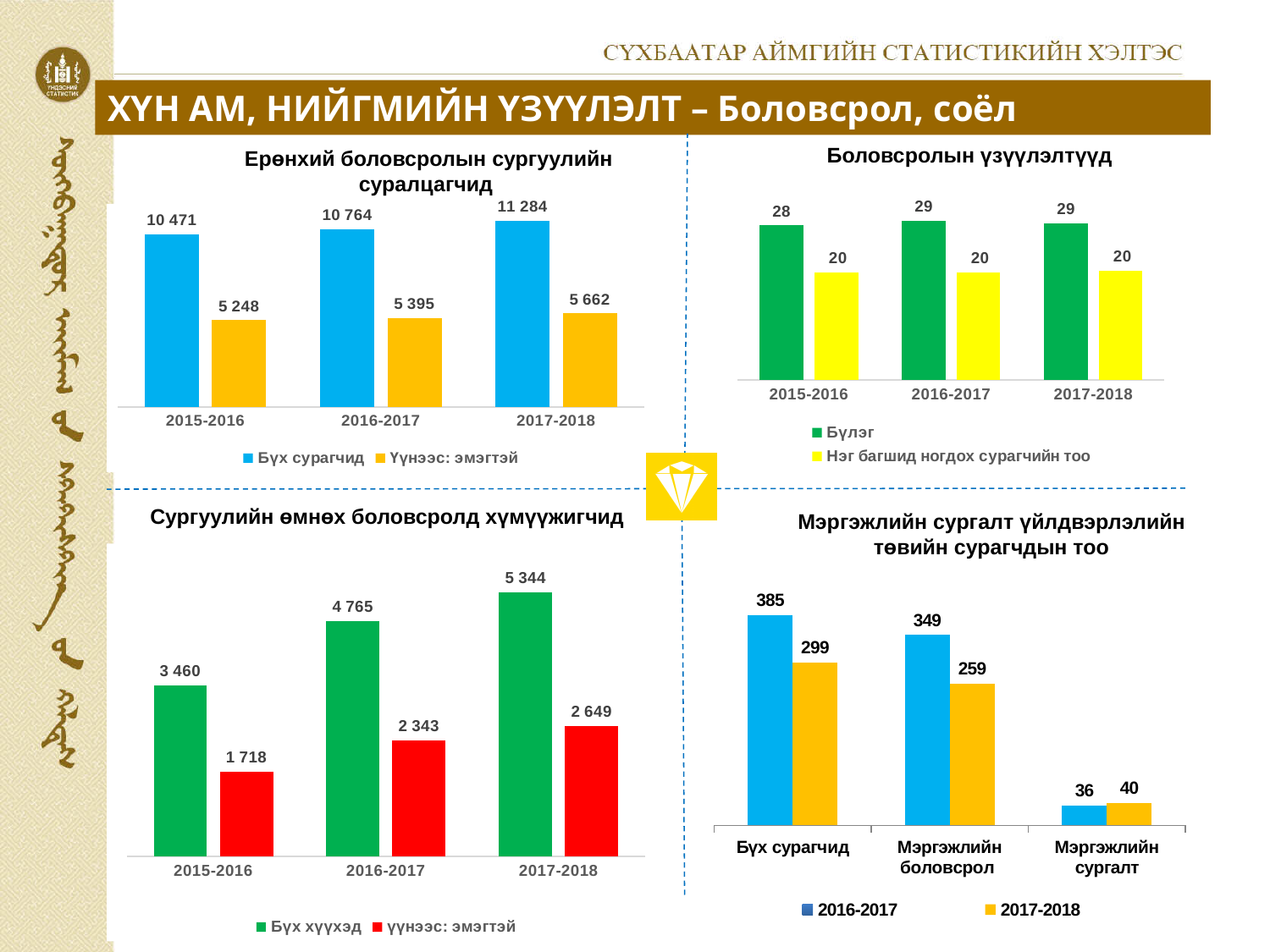
In the chart titled "Мэргэжлийн сургалт үйлдвэрлэлийн төвийн сурагчдын тоо", which is larger for "Мэргэжлийн сургалт": 2016-2017 or 2017-2018? 2017-2018 In the chart titled "Мэргэжлийн сургалт үйлдвэрлэлийн төвийн сурагчдын тоо", what is the value for "Мэргэжлийн боловсрол" in 2017-2018? 259 In the chart titled "Ерөнхий боловсролын сургуулийн суралцагчид", do the values for "Бүх сурагчид" rise or fall from 2015-2016 to 2017-2018? rise In the chart titled "Сургуулийн өмнөх боловсролд хүмүүжигчид", what kind of chart is shown? bar chart In the chart titled "Ерөнхий боловсролын сургуулийн суралцагчид", what is the difference between "Бүх сурагчид" and "Үүнээс: эмэгтэй" for 2015-2016? 5 223 In the chart titled "Мэргэжлийн сургалт үйлдвэрлэлийн төвийн сурагчдын тоо", how many categories are shown on the x axis? 3 In the chart titled "Боловсролын үзүүлэлтүүд", how many series does the legend list? 2 In the chart titled "Ерөнхий боловсролын сургуулийн суралцагчид", what is the value of "Бүх сурагчид" for 2017-2018? 11 284 In the chart titled "Боловсролын үзүүлэлтүүд", what is the value of "Нэг багшид ногдох сурагчийн тоо" for 2017-2018? 20 In the chart titled "Сургуулийн өмнөх боловсролд хүмүүжигчид", what is the value of "үүнээс: эмэгтэй" for 2016-2017? 2 343 In the chart titled "Боловсролын үзүүлэлтүүд", what is the value of "Бүлэг" for 2015-2016? 28 In the chart titled "Сургуулийн өмнөх боловсролд хүмүүжигчид", which year has the highest value for "Бүх хүүхэд"? 2017-2018